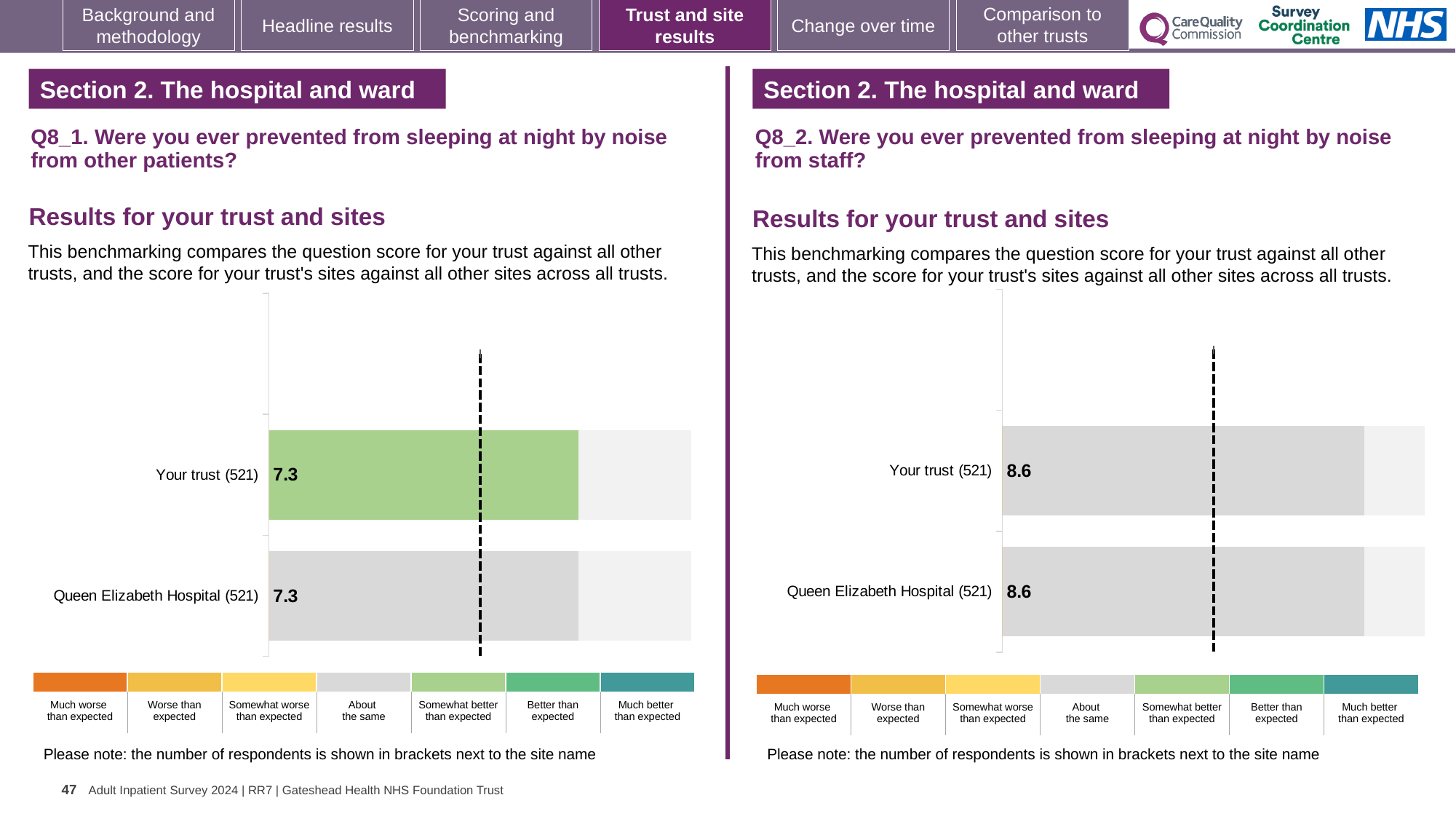
In the Q8_2 chart (right), what is the score for Your trust (521)? 8.6 How many bars are plotted in the Q8_2 chart (right)? 2 In the Q8_1 chart (left), what is the difference between the score for Your trust and the score for Queen Elizabeth Hospital? 0 How many benchmark categories are shown in the colour key below the Q8_2 chart (right)? 7 How many respondents are shown in brackets for Your trust in the Q8_1 chart (left)? 521 What kind of chart is used for the Q8_2 results (right)? Bar chart In the Q8_1 chart (left), what is the score for Your trust (521)? 7.3 In the Q8_1 chart (left), what is the score for Queen Elizabeth Hospital (521)? 7.3 In the Q8_2 chart (right), what is the difference between the score for Your trust and the score for Queen Elizabeth Hospital? 0 How many bars are plotted in the Q8_1 chart (left)? 2 In the Q8_1 chart (left), which benchmark category does the colour of the Your trust bar correspond to? Somewhat better than expected In the Q8_2 chart (right), what is the score for Queen Elizabeth Hospital (521)? 8.6